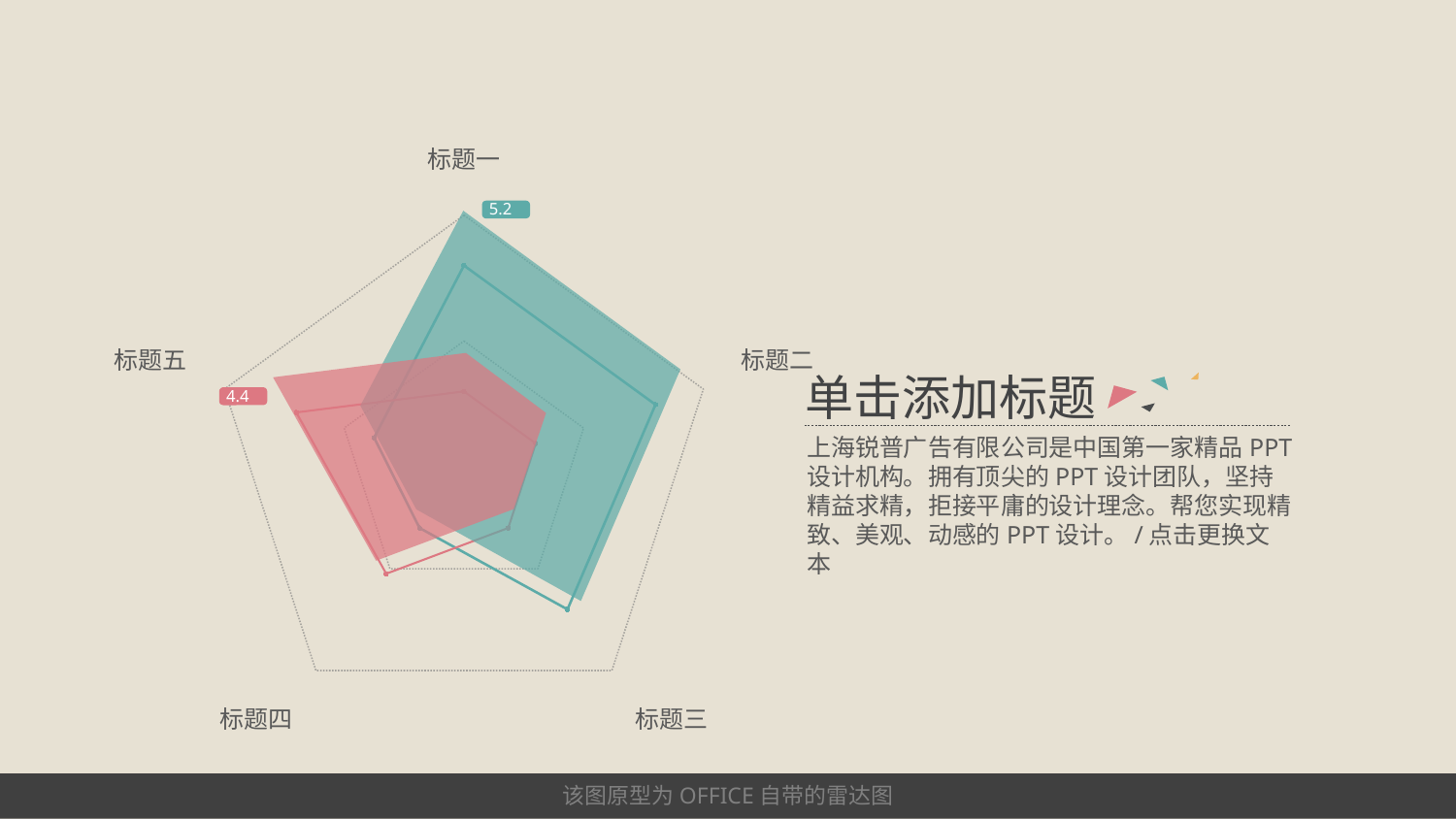
Which category label appears at the top of the radar chart? 标题一 What is the value of the teal series for 标题一? 5.2 For 标题五, which series has the larger value, the teal or the pink one? Pink What two colours are used for the two series on the radar chart? Teal and pink What kind of chart is shown on the slide? Radar chart For 标题一, which series has the larger value, the teal or the pink one? Teal In which category does the pink series reach its highest value? 标题五 Which category carries the data label 5.2? 标题一 How many data series are plotted on the radar chart? 2 For 标题二, which series has the larger value, the teal or the pink one? Teal How many categories (axes) does the radar chart have? 5 What is the value of the pink series for 标题五? 4.4